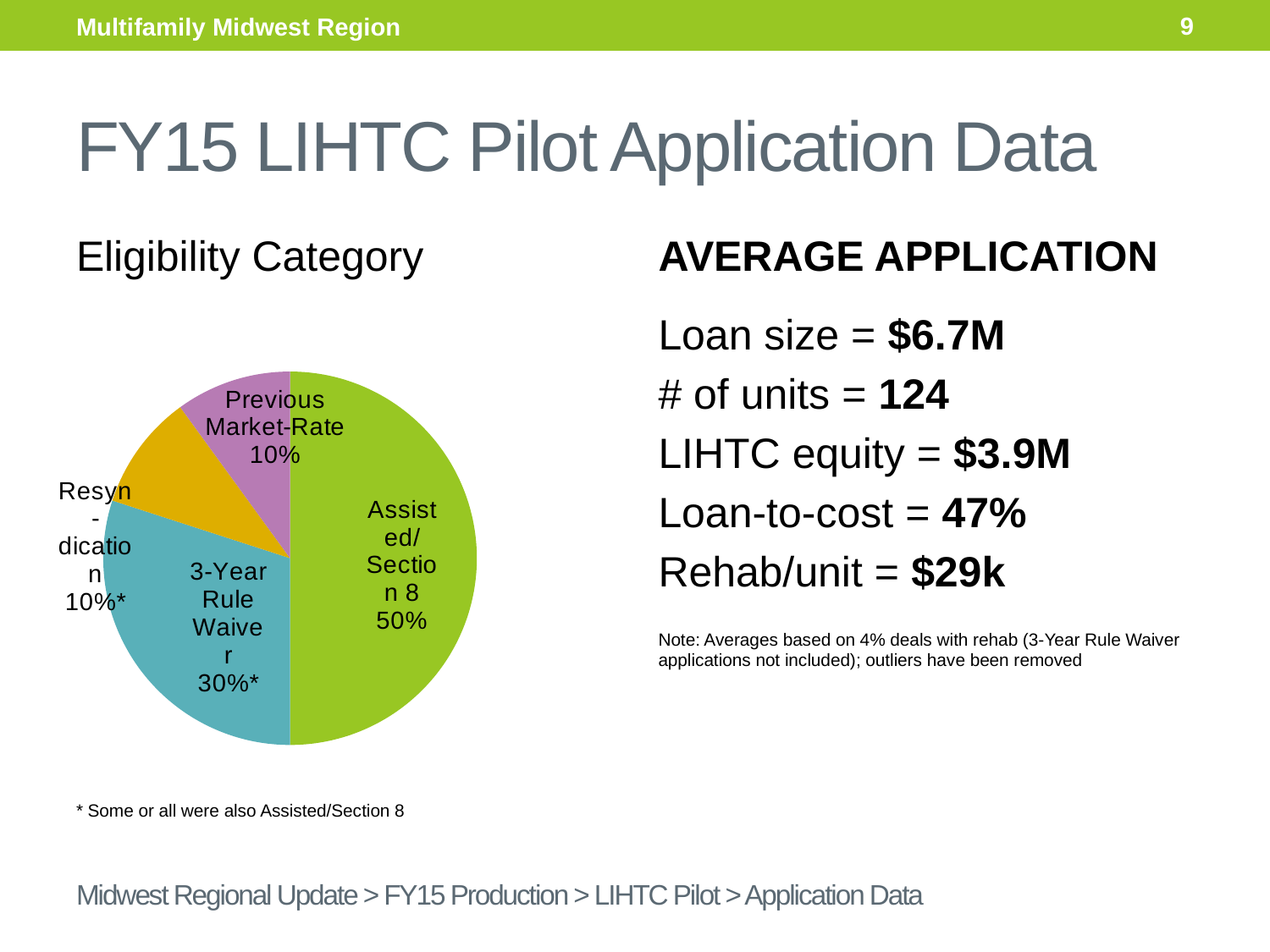
What type of chart is used to show Eligibility Category? Pie chart In the Eligibility Category pie chart, how many percentage points larger is Assisted/Section 8 than 3-Year Rule Waiver? 20 percentage points Which two categories share the smallest slice in the Eligibility Category pie chart? Resyndication and Previous Market-Rate In the Eligibility Category pie chart, what percentage is shown for 3-Year Rule Waiver? 30% In the Eligibility Category pie chart, what percentage is shown for Previous Market-Rate? 10% What is the title of the chart on the slide? Eligibility Category In the Eligibility Category pie chart, what combined share do 3-Year Rule Waiver and Resyndication make up? 40% How many slices does the Eligibility Category pie chart have? 4 In the Eligibility Category pie chart, what percentage is shown for Resyndication? 10% In the Eligibility Category pie chart, which is larger: 3-Year Rule Waiver or Previous Market-Rate? 3-Year Rule Waiver In the Eligibility Category pie chart, what percentage is shown for Assisted/Section 8? 50% Which category has the largest slice in the Eligibility Category pie chart? Assisted/Section 8